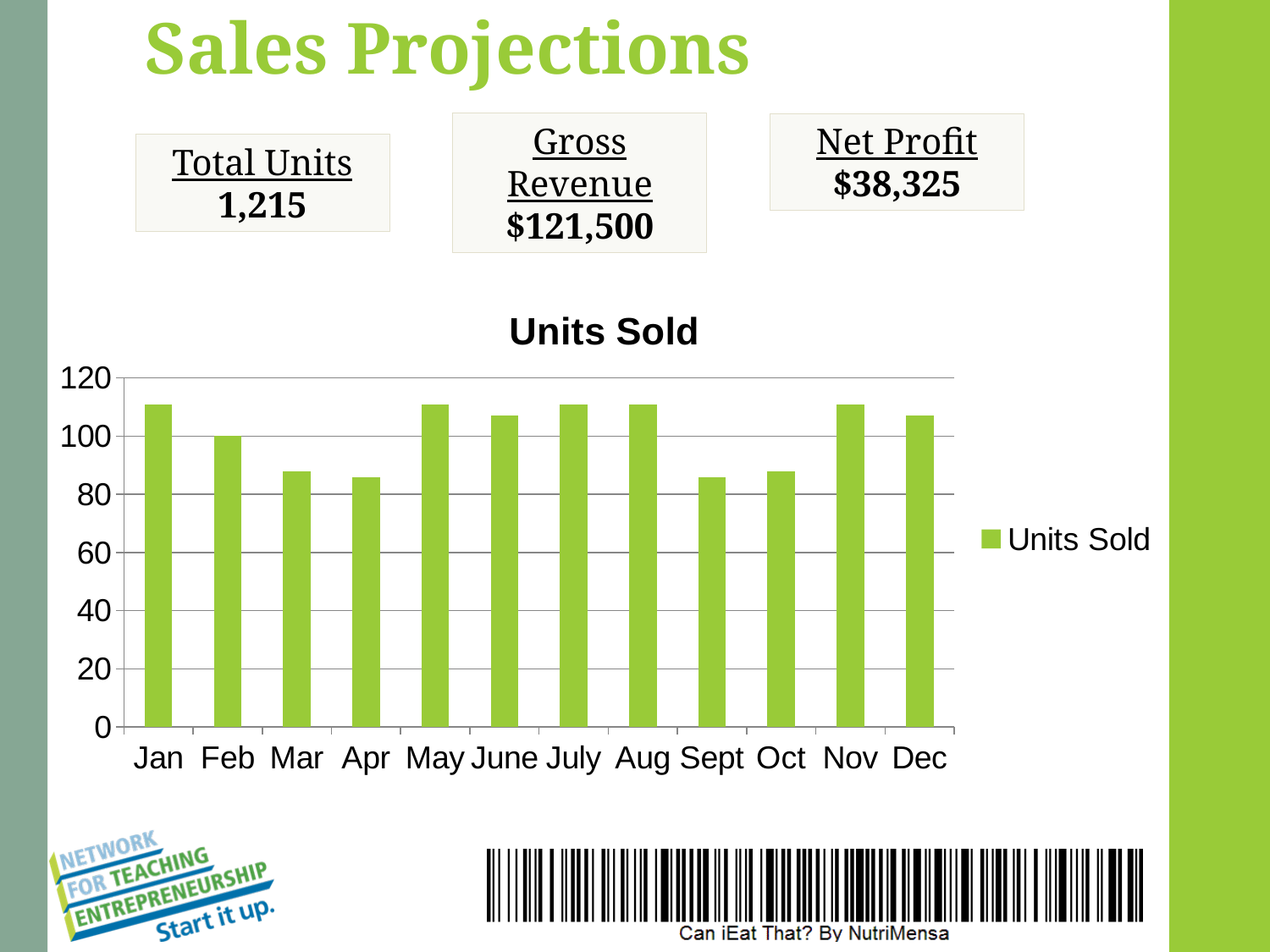
What is the title of the chart? Units Sold How many months are plotted on the x axis of the chart? 12 What colour are the bars in the Units Sold chart? green Is the value for Mar greater or less than 80? greater What kind of chart is shown on the slide? bar chart Which is larger, the value for Jan or the value for Feb? Jan How many series does the chart's legend list? 1 Which is larger, the value for Feb or the value for Mar? Feb Is the value for Sept greater or less than 100? less Is the value for Apr greater or less than 100? less What is the value for Feb in the Units Sold chart? 100